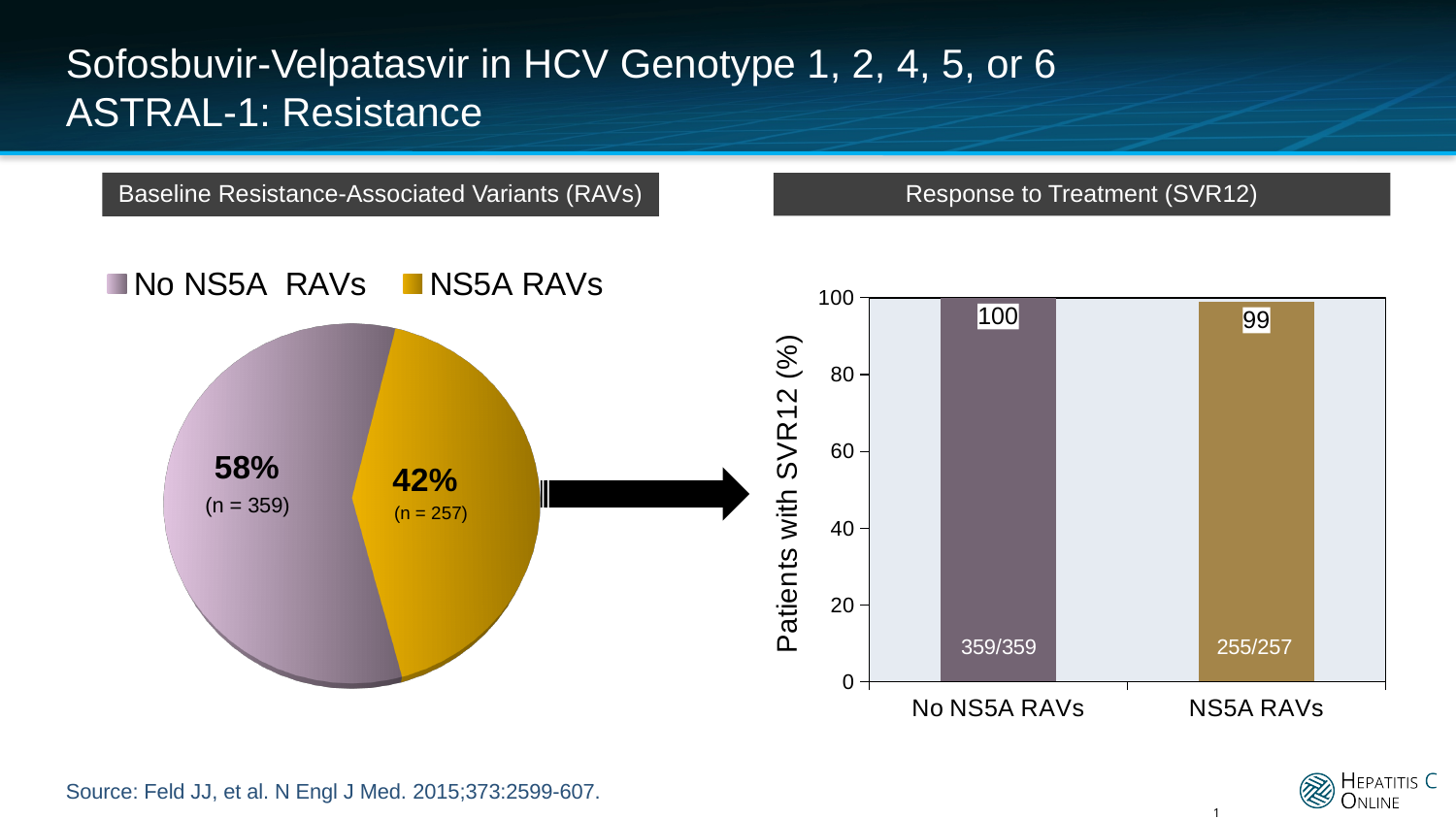
In the Baseline Resistance-Associated Variants (RAVs) pie chart, which slice is larger? No NS5A RAVs In the Response to Treatment (SVR12) chart, what fraction is printed on the NS5A RAVs bar? 255/257 In the Baseline Resistance-Associated Variants (RAVs) pie chart, what share of patients had NS5A RAVs? 42% In the Response to Treatment (SVR12) chart, what is the SVR12 value for No NS5A RAVs? 100 In the Response to Treatment (SVR12) chart, what is the SVR12 value for NS5A RAVs? 99 In the Baseline Resistance-Associated Variants (RAVs) pie chart, how many patients are in the NS5A RAVs slice? n = 257 What is the y-axis label of the Response to Treatment (SVR12) chart? Patients with SVR12 (%) How many entries does the legend of the Baseline Resistance-Associated Variants (RAVs) pie chart list? 2 In the Response to Treatment (SVR12) chart, what is the difference in SVR12 between No NS5A RAVs and NS5A RAVs? 1 In the Baseline Resistance-Associated Variants (RAVs) pie chart, what share of patients had No NS5A RAVs? 58% What kind of chart is shown on the right side of the slide? Bar chart What kind of chart is shown on the left side of the slide? Pie chart